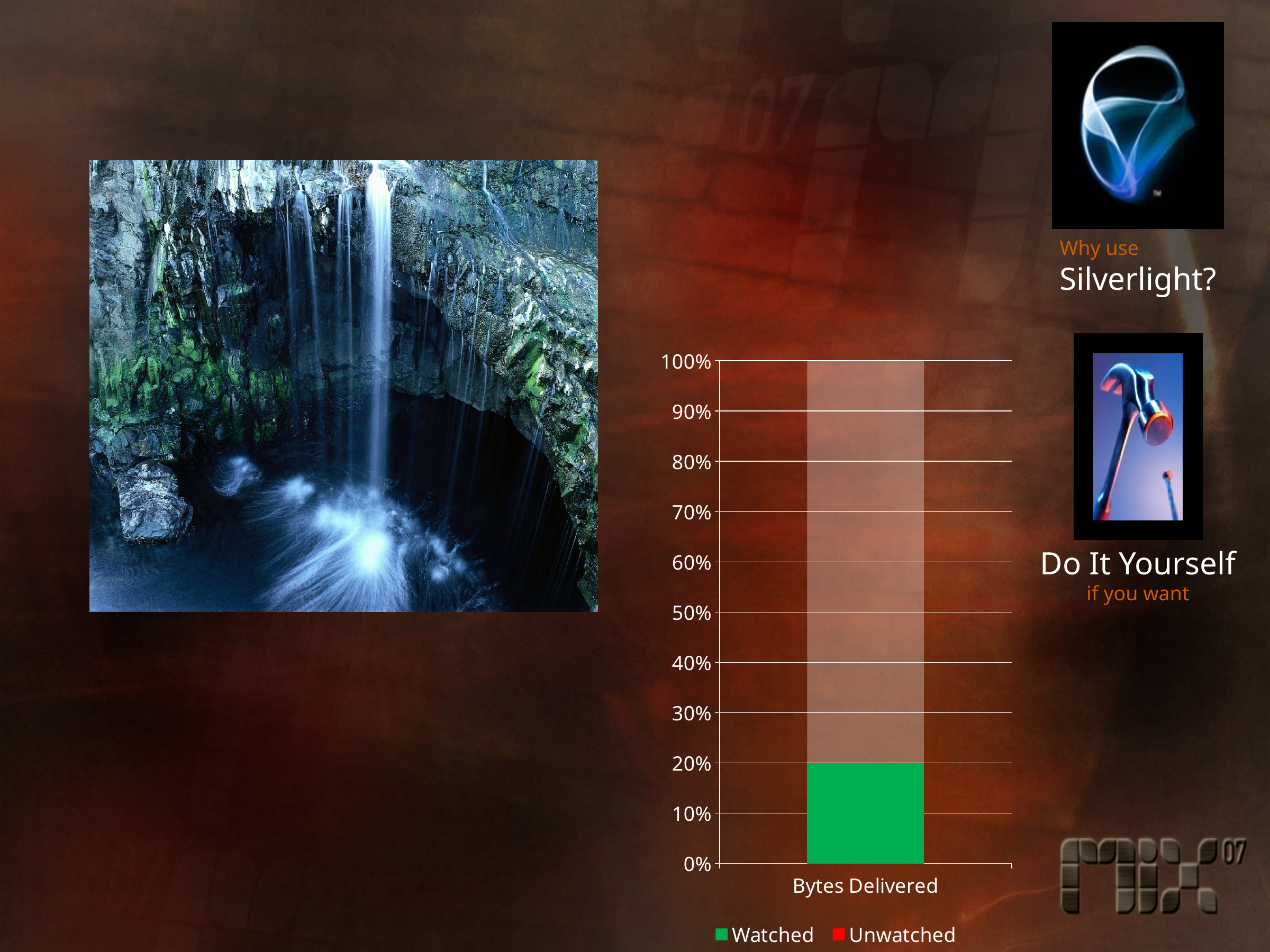
What is the label of the category on the x axis? Bytes Delivered Which series is larger for Bytes Delivered, Watched or Unwatched? Unwatched What is the total height of the stacked bar for Bytes Delivered? 100% Is the Watched value for Bytes Delivered greater or less than 50%? less How many series does the chart legend list? 2 What is the value of the Watched series for Bytes Delivered? 20% Which series has the smallest value for Bytes Delivered? Watched Which series is shown in green in the legend? Watched Is the Unwatched value for Bytes Delivered greater or less than 50%? greater Which series has the largest value for Bytes Delivered? Unwatched How many categories are shown on the x axis of the chart? 1 What type of chart is shown on the slide? bar chart